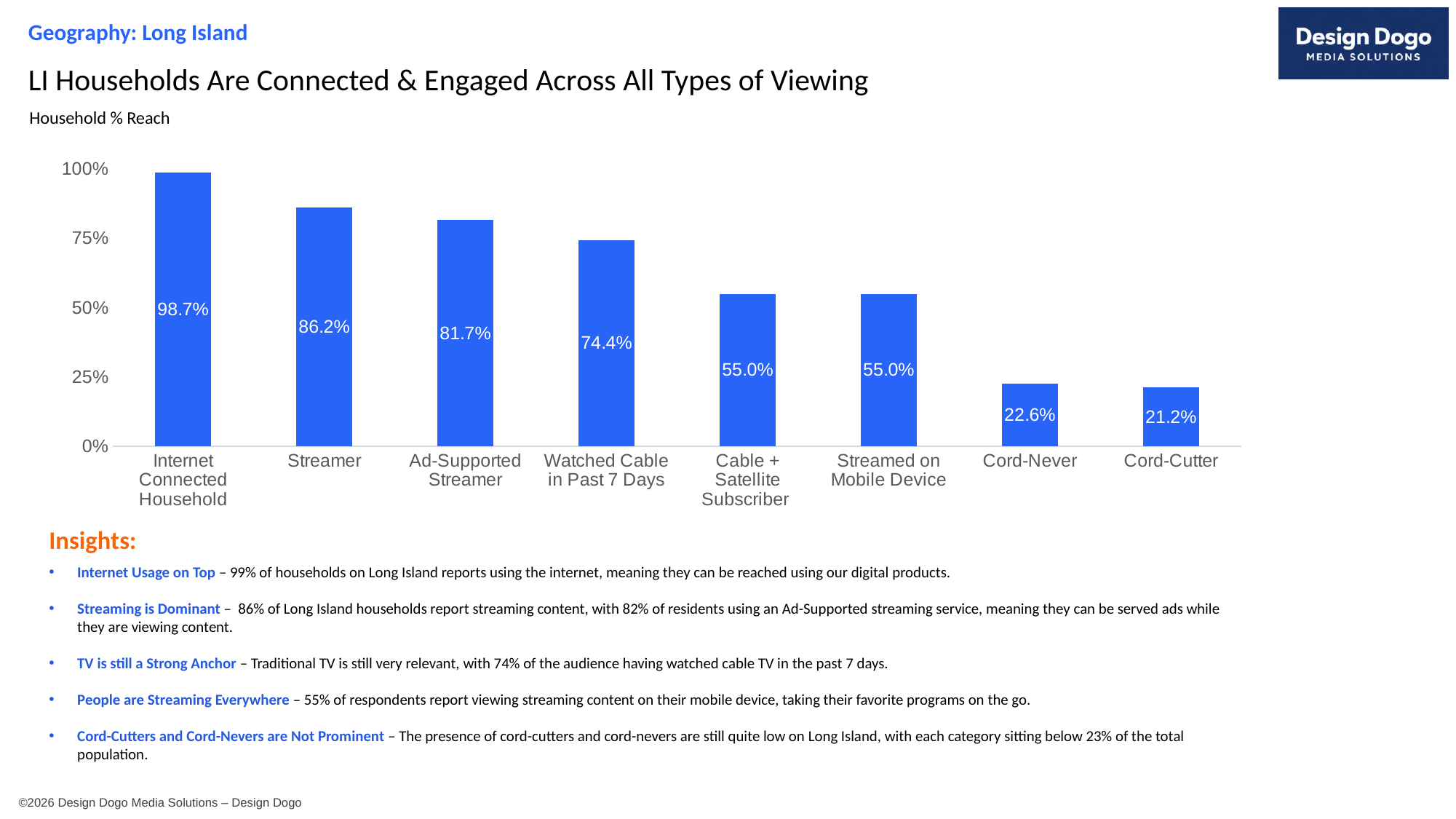
Which category has the highest household % reach? Internet Connected Household What is the difference in household % reach between Internet Connected Household and Streamer? 12.5% How many categories are shown on the x axis of the chart? 8 What is the household % reach for Watched Cable in Past 7 Days? 74.4% What is the household % reach for Streamer? 86.2% Which has a higher household % reach, Ad-Supported Streamer or Watched Cable in Past 7 Days? Ad-Supported Streamer Is the value for Cord-Never greater or less than 25%? less What is the difference in household % reach between Cord-Never and Cord-Cutter? 1.4% Which category has the lowest household % reach? Cord-Cutter What is the household % reach for Cable + Satellite Subscriber? 55.0% What kind of chart is shown on the slide? Bar chart What is the household % reach for Cord-Cutter? 21.2%